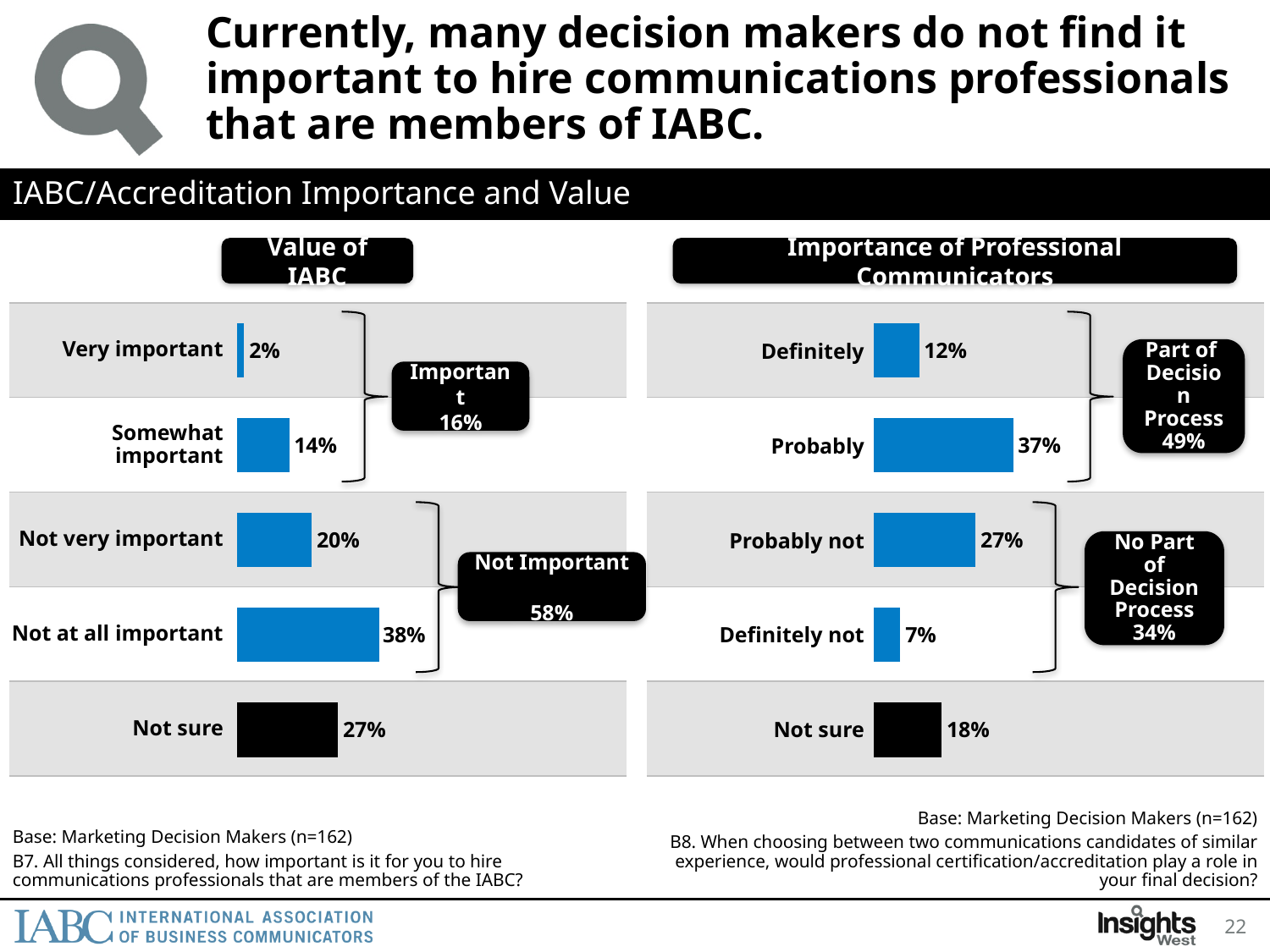
How many categories are shown in the 'Importance of Professional Communicators' chart? 5 In the 'Value of IABC' chart, what is the difference between 'Not at all important' and 'Not very important'? 18% In the 'Value of IABC' chart, which category has the highest value? Not at all important In the 'Importance of Professional Communicators' chart, which category has the lowest value? Definitely not In the 'Importance of Professional Communicators' chart, what percentage of respondents said 'Probably'? 37% In the 'Value of IABC' chart, what percentage of respondents said 'Not at all important'? 38% In the 'Importance of Professional Communicators' chart, what is the difference between 'Probably' and 'Probably not'? 10% In the 'Importance of Professional Communicators' chart, what percentage of respondents said 'Not sure'? 18% In the 'Value of IABC' chart, what percentage of respondents said 'Very important'? 2% What type of chart is the 'Value of IABC' chart? Bar chart In the 'Importance of Professional Communicators' chart, what combined percentage is labelled 'Part of Decision Process'? 49% In the 'Value of IABC' chart, which is larger: 'Not sure' or 'Somewhat important'? Not sure